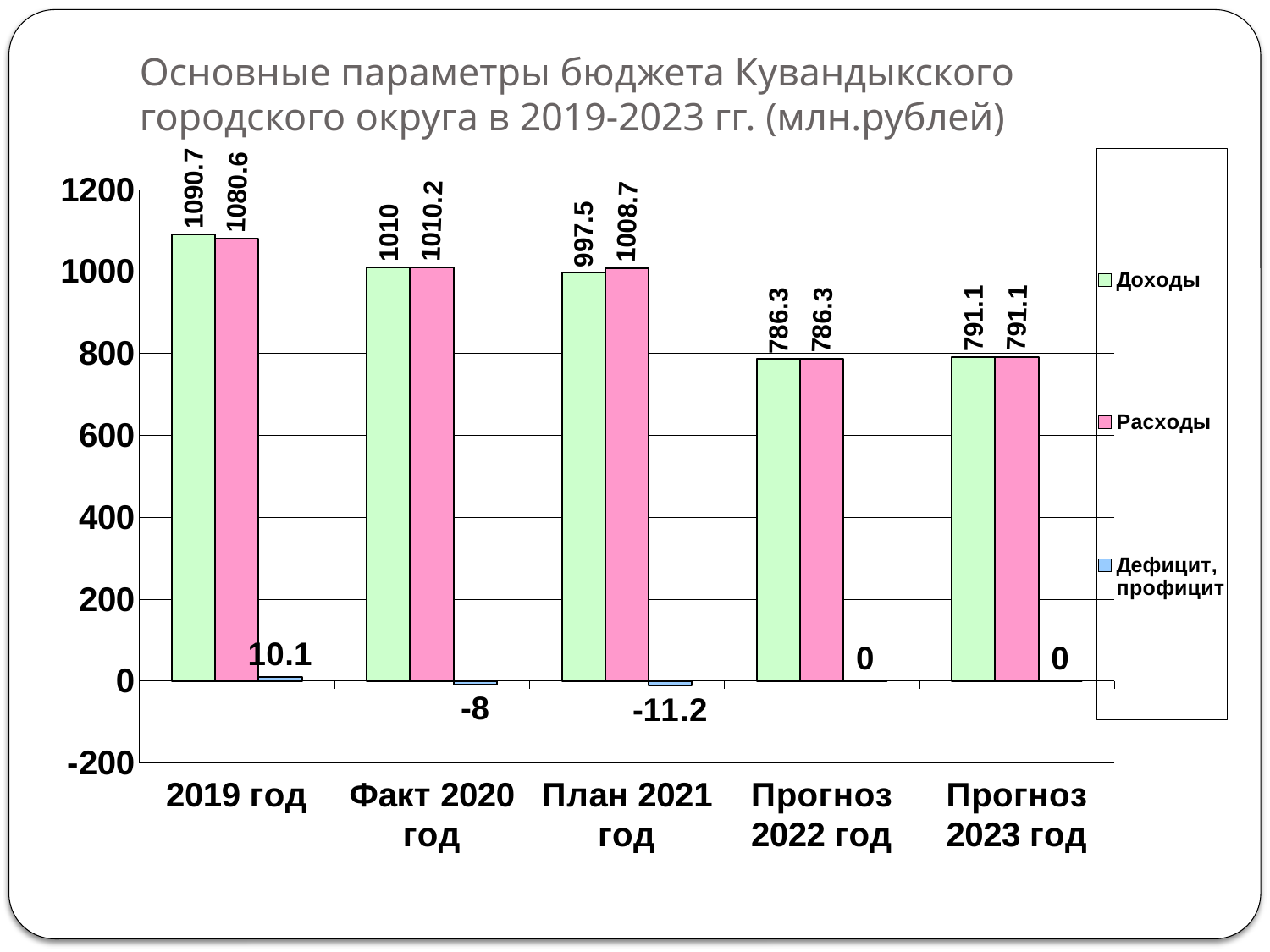
What is the value of Расходы for План 2021 год? 1008.7 Which is larger for Факт 2020 год: Доходы or Расходы? Расходы Which category has the highest value of Доходы? 2019 год How many series does the legend list? 3 Which category has the lowest value of Расходы? Прогноз 2022 год What kind of chart is shown on the slide? Bar chart What is the value of Дефицит, профицит for План 2021 год? -11.2 Do the Доходы values generally rise or fall from 2019 год to Прогноз 2022 год? Fall What is the difference between Доходы and Расходы for 2019 год? 10.1 What is the value of Доходы for 2019 год? 1090.7 How many categories are shown on the x axis? 5 What is the value of Дефицит, профицит for Факт 2020 год? -8